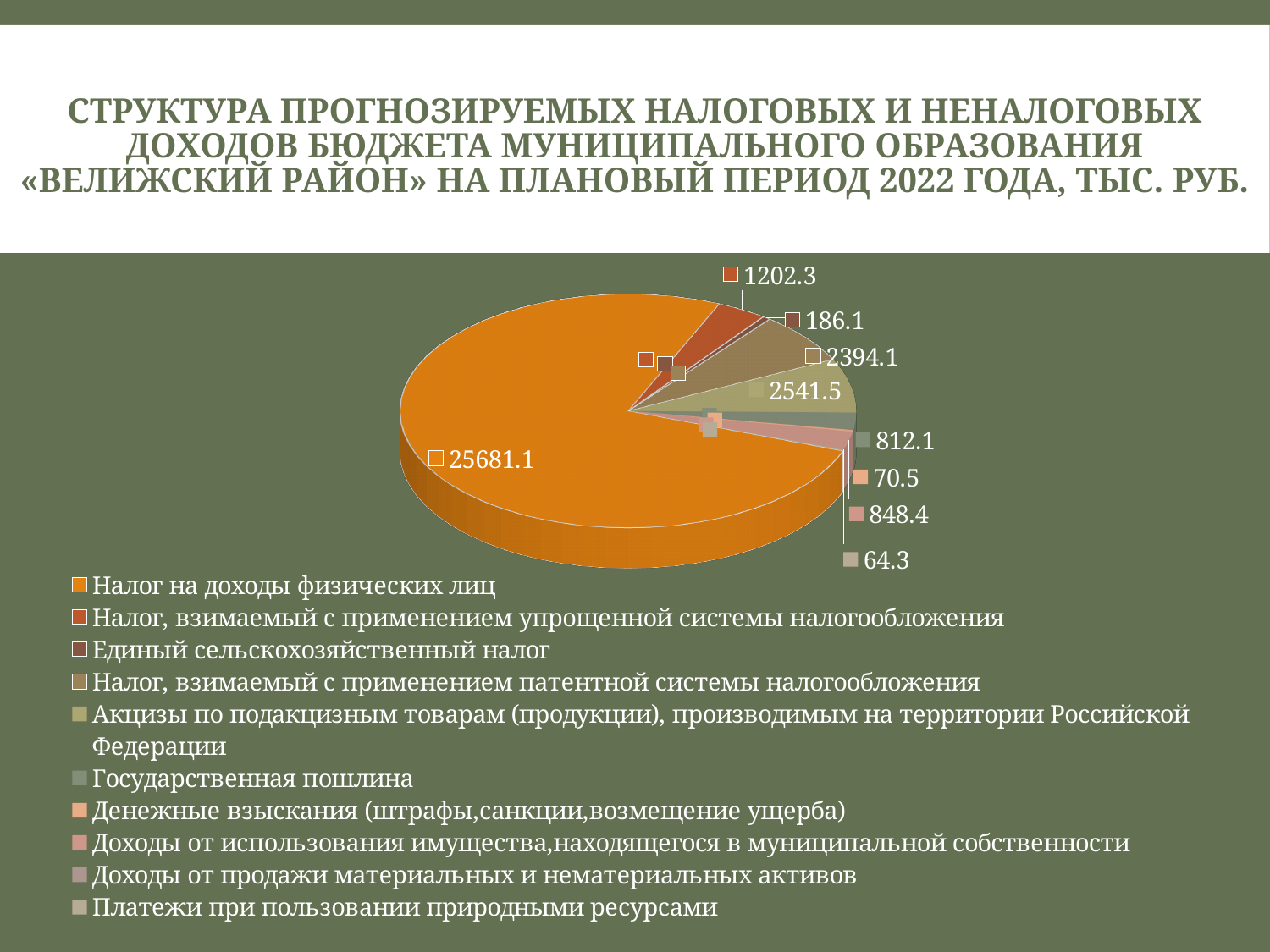
What is the value shown for Денежные взыскания (штрафы, санкции, возмещение ущерба)? 70.5 Which category has the largest slice in the pie chart? Налог на доходы физических лиц What is the value shown for Доходы от использования имущества, находящегося в муниципальной собственности? 848.4 What is the value shown for Единый сельскохозяйственный налог? 186.1 Which is larger: the value for Налог, взимаемый с применением упрощенной системы налогообложения or the value for Единый сельскохозяйственный налог? Налог, взимаемый с применением упрощенной системы налогообложения What kind of chart is shown on the slide? pie chart In what units are the values in the chart expressed, according to the slide title? тыс. руб. What is the value shown for Налог на доходы физических лиц? 25681.1 How many categories does the legend of the pie chart list? 10 What is the value shown for Налог, взимаемый с применением упрощенной системы налогообложения? 1202.3 What is the value shown for Налог, взимаемый с применением патентной системы налогообложения? 2394.1 What is the difference between the value for Налог, взимаемый с применением упрощенной системы налогообложения (1202.3) and the value for Единый сельскохозяйственный налог (186.1)? 1016.2